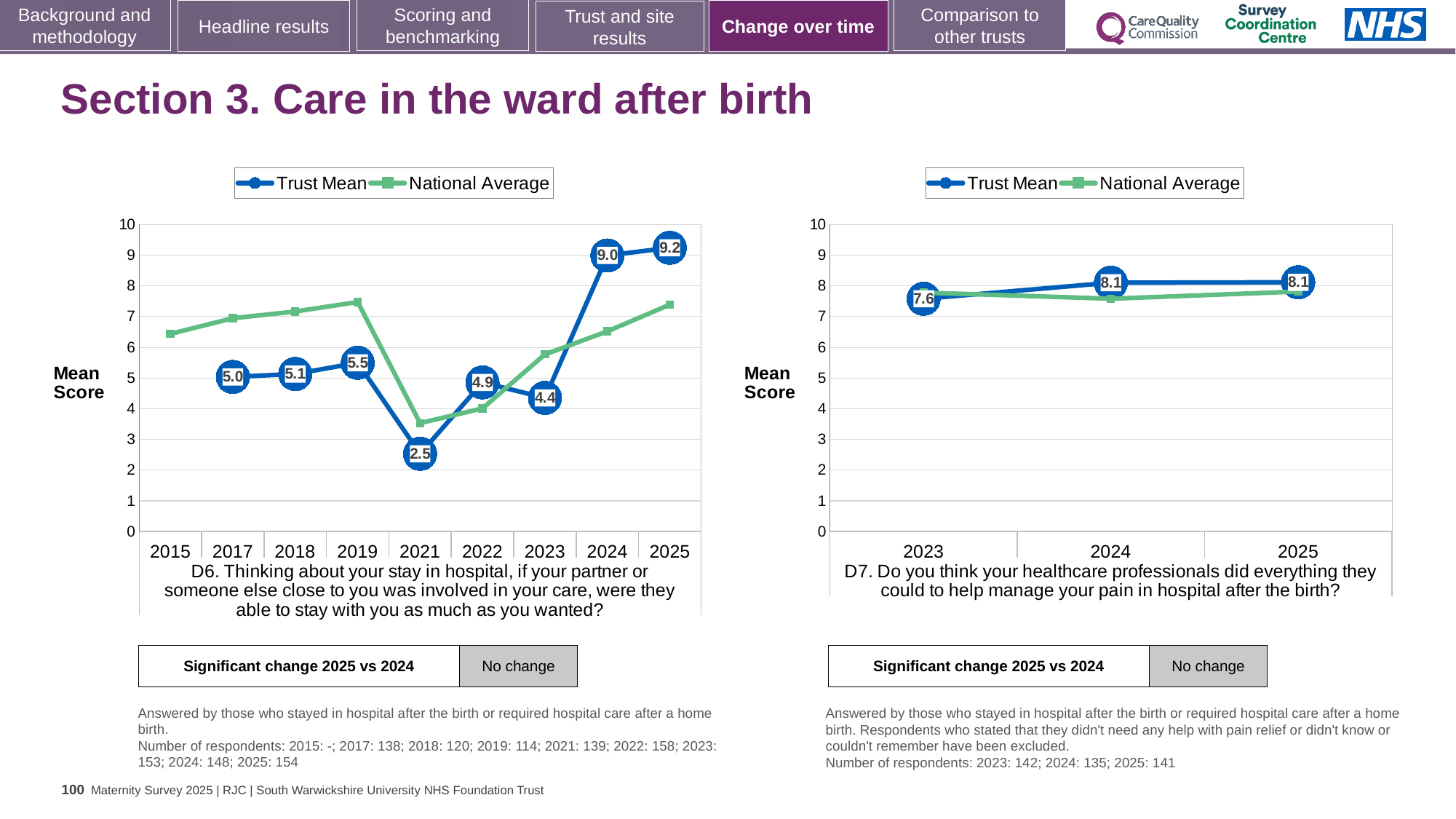
In the left chart (D6), is the National Average for 2015 greater or less than 6? greater How many years are shown on the x axis of the left chart (D6)? 9 In the left chart (D6), which year has the lowest Trust Mean score? 2021 In the right chart (D7), what is the difference between the Trust Mean scores for 2024 and 2023? 0.5 In the right chart (D7), what is the Trust Mean score for 2023? 7.6 In the left chart (D6), what is the Trust Mean score for 2025? 9.2 How many series does the legend of the right chart (D7) list? 2 In the left chart (D6), which year has the highest Trust Mean score? 2025 In the left chart (D6), what is the difference between the Trust Mean scores for 2024 and 2023? 4.6 What type of chart is the right chart (D7)? Line chart In the left chart (D6), which is larger in 2019, the Trust Mean or the National Average? National Average In the left chart (D6), what is the Trust Mean score for 2021? 2.5